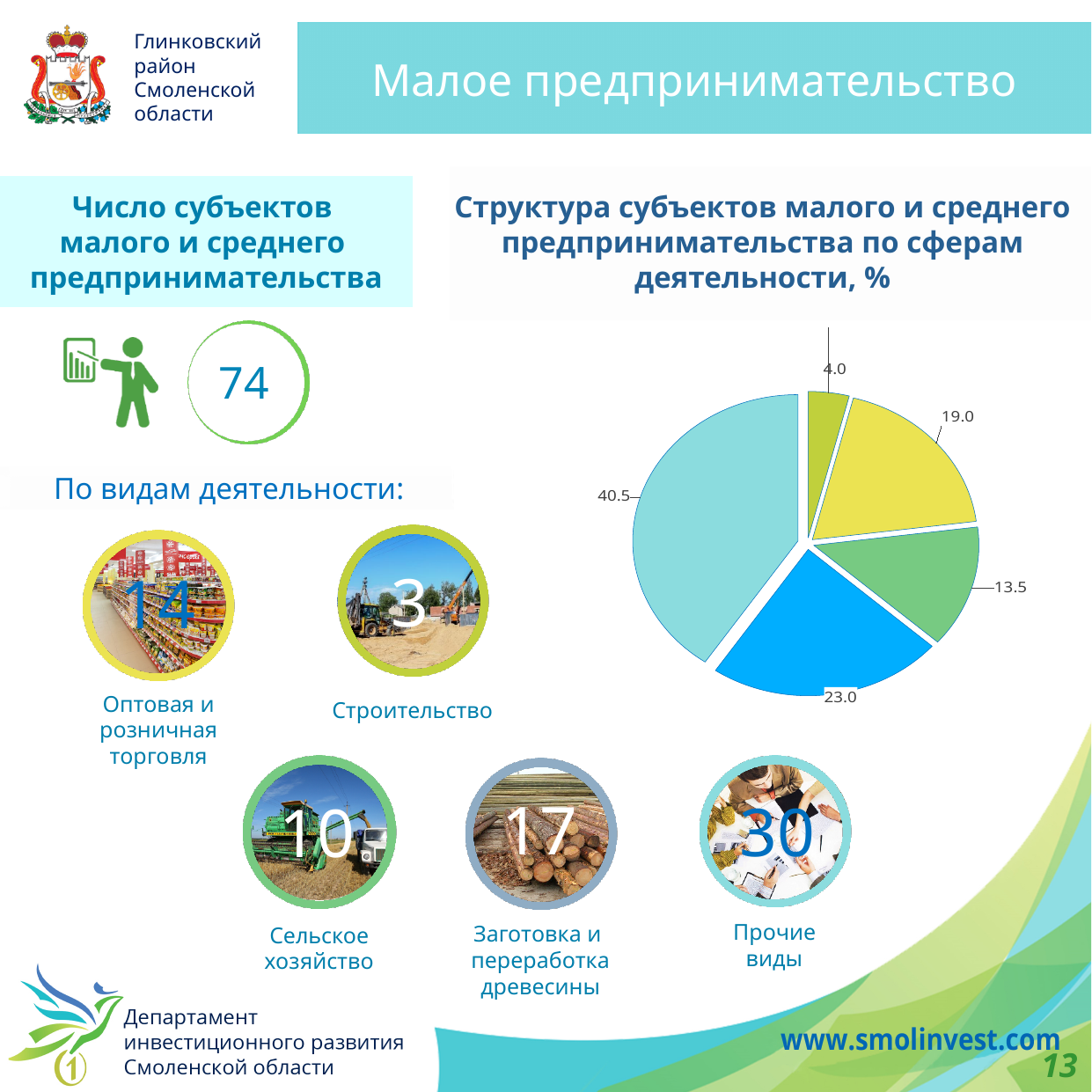
What is the value of the dark blue slice in the pie chart? 23.0 How many slices does the pie chart have? 5 What is the sum of all the slice values shown in the pie chart? 100.0 What is the value of the largest slice in the pie chart? 40.5 What is the difference between the 23.0 slice and the 19.0 slice in the pie chart? 4.0 What kind of chart is shown under the title "Структура субъектов малого и среднего предпринимательства по сферам деятельности, %"? pie chart What is the second-largest value shown in the pie chart? 23.0 What is the value of the light cyan (largest) slice in the pie chart? 40.5 Which is larger in the pie chart, the slice labelled 19.0 or the slice labelled 13.5? 19.0 Is the largest slice of the pie chart greater or less than 40? greater What is the difference between the largest slice (40.5) and the smallest slice (4.0) in the pie chart? 36.5 What is the value of the smallest slice in the pie chart? 4.0